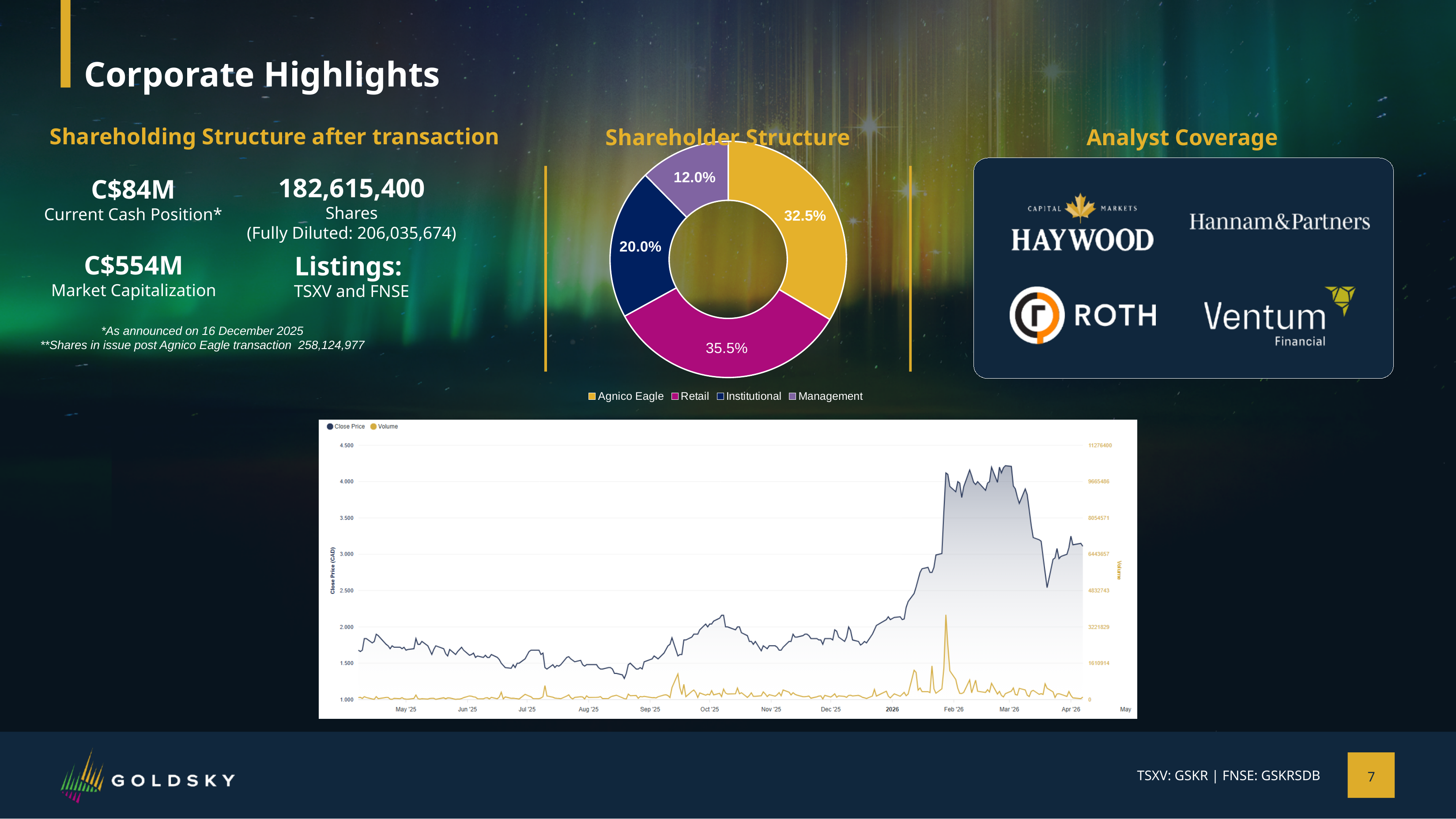
How many shareholder groups are shown in the Shareholder Structure chart? 4 In the Shareholder Structure chart, what percentage is held by Agnico Eagle? 32.5% What kind of chart is the Shareholder Structure chart? Pie (donut) chart In the Shareholder Structure chart, which shareholder group has the smallest share? Management In the Shareholder Structure chart, what percentage is held by Management? 12.0% In the Shareholder Structure chart, which is larger: the Institutional share or the Management share? Institutional In the Shareholder Structure chart, what percentage is held by Institutional shareholders? 20.0% In the Shareholder Structure chart, what percentage is held by Retail? 35.5% How many series does the legend of the stock price chart at the bottom of the slide list? 2 In the Shareholder Structure chart, which shareholder group has the largest share? Retail In the Shareholder Structure chart, how many percentage points larger is the Retail share than the Agnico Eagle share? 3.0% In the stock price chart at the bottom of the slide, is the Close Price at Feb '26 greater or less than 3.500? greater